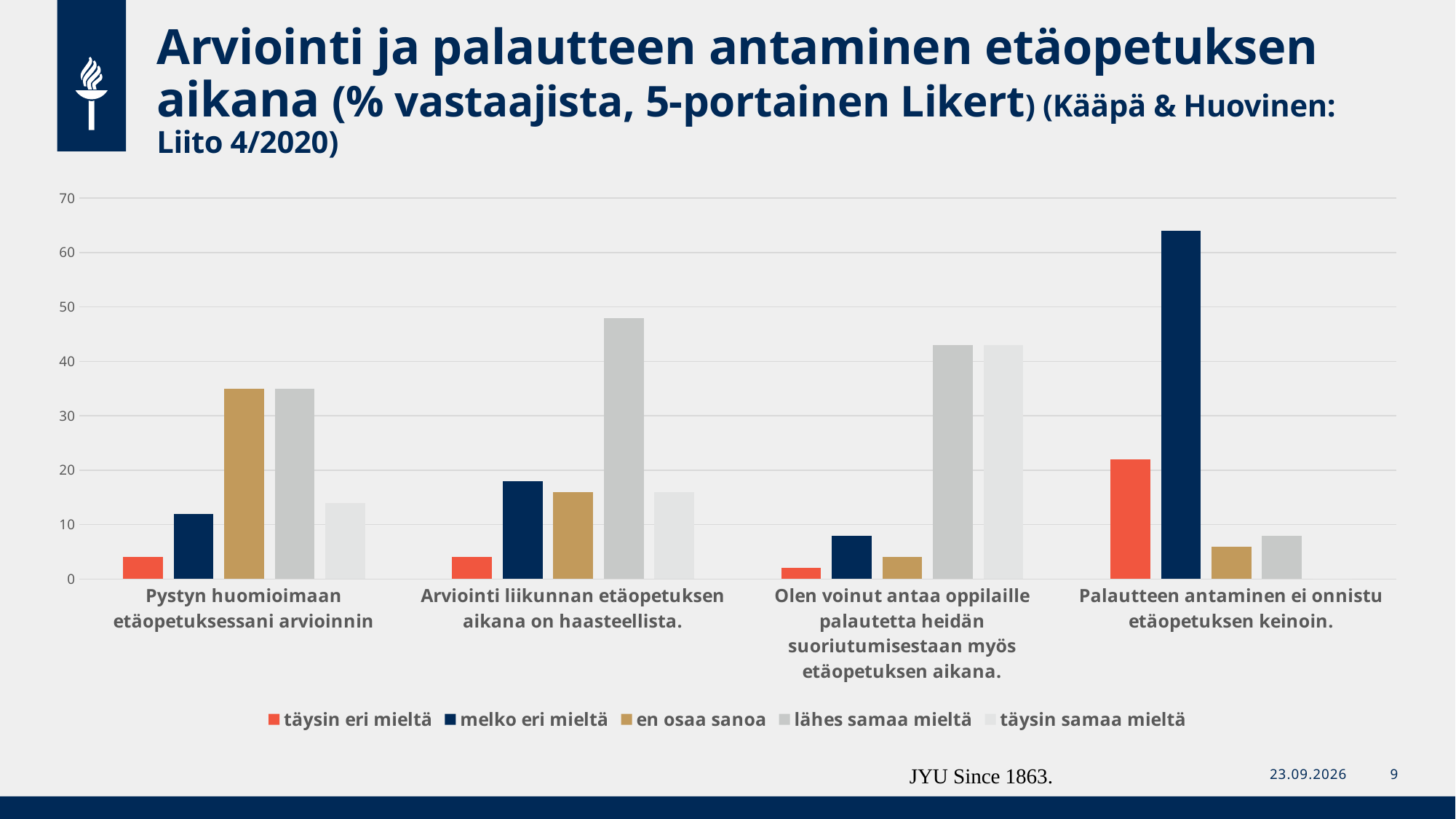
What kind of chart is shown on the slide? bar chart For which statement is the 'melko eri mieltä' bar the highest? Palautteen antaminen ei onnistu etäopetuksen keinoin. How many statement categories are shown on the x axis? 4 Is the 'täysin eri mieltä' value for 'Palautteen antaminen ei onnistu etäopetuksen keinoin.' greater or less than 10? greater How many series does the legend list? 5 What colour represents 'täysin eri mieltä' in the legend? red/orange Is the 'lähes samaa mieltä' value for 'Arviointi liikunnan etäopetuksen aikana on haasteellista.' greater or less than 40? greater Is the 'melko eri mieltä' value for 'Palautteen antaminen ei onnistu etäopetuksen keinoin.' greater or less than 60? greater For 'Olen voinut antaa oppilaille palautetta heidän suoriutumisestaan myös etäopetuksen aikana.', which series has the lowest bar? täysin eri mieltä For 'Pystyn huomioimaan etäopetuksessani arvioinnin', which is larger: 'en osaa sanoa' or 'täysin samaa mieltä'? en osaa sanoa For 'Arviointi liikunnan etäopetuksen aikana on haasteellista.', which series has the highest bar? lähes samaa mieltä